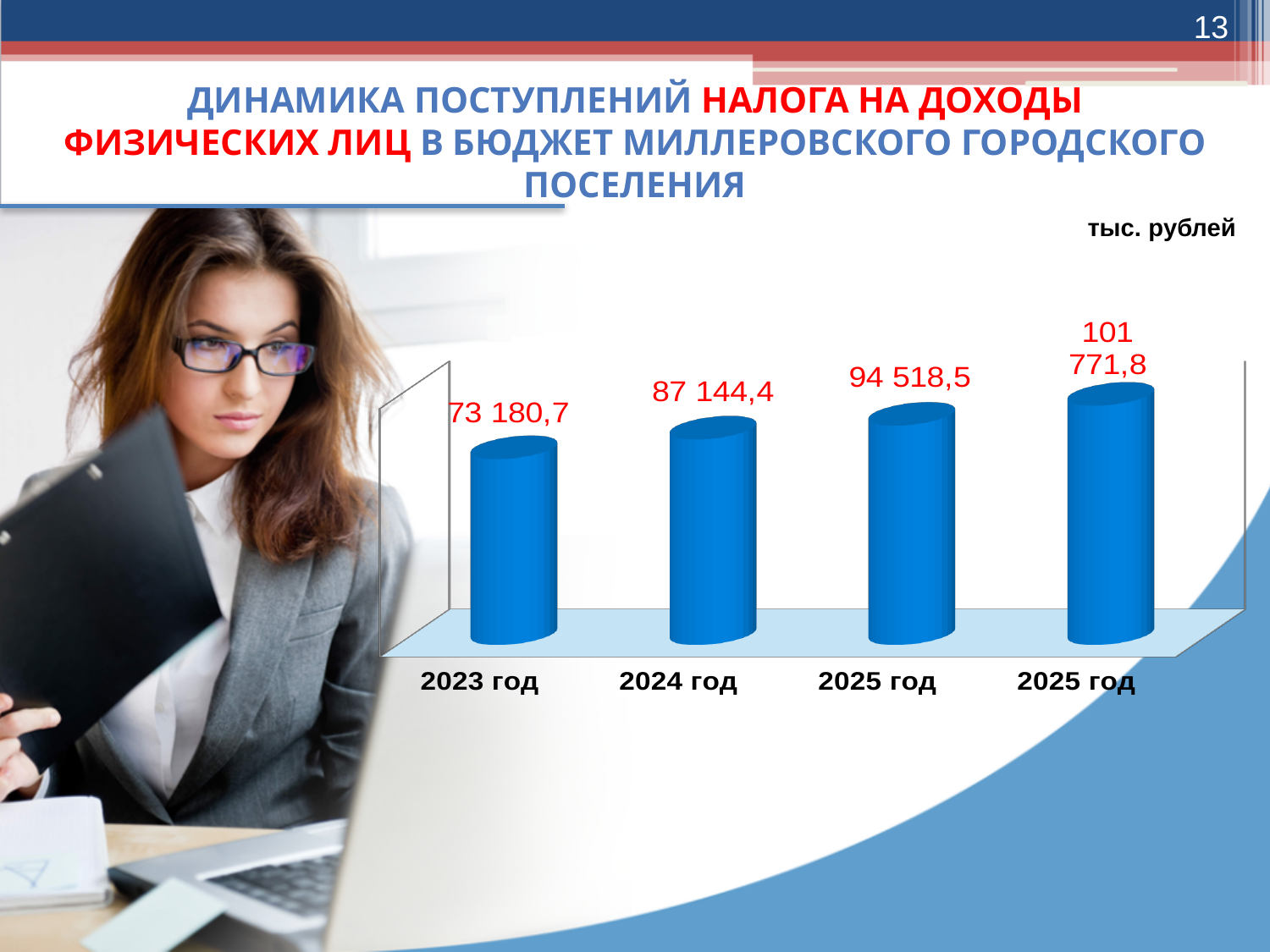
What is the value shown on the rightmost (fourth) bar? 101 771,8 What is the difference between the values for 2024 год and 2023 год? 13 963,7 How many bars are shown in the chart? 4 What is the difference between the rightmost bar and the third bar? 7 253,3 Which is larger, the value for 2023 год or the value for 2024 год? 2024 год What is the value shown on the third bar from the left? 94 518,5 Do the values rise or fall from left to right along the x axis? Rise Which category has the lowest value? 2023 год What kind of chart is shown on the slide? Bar chart What is the value for 2024 год? 87 144,4 What is the value for 2023 год? 73 180,7 Which bar has the highest value? The rightmost bar (101 771,8)